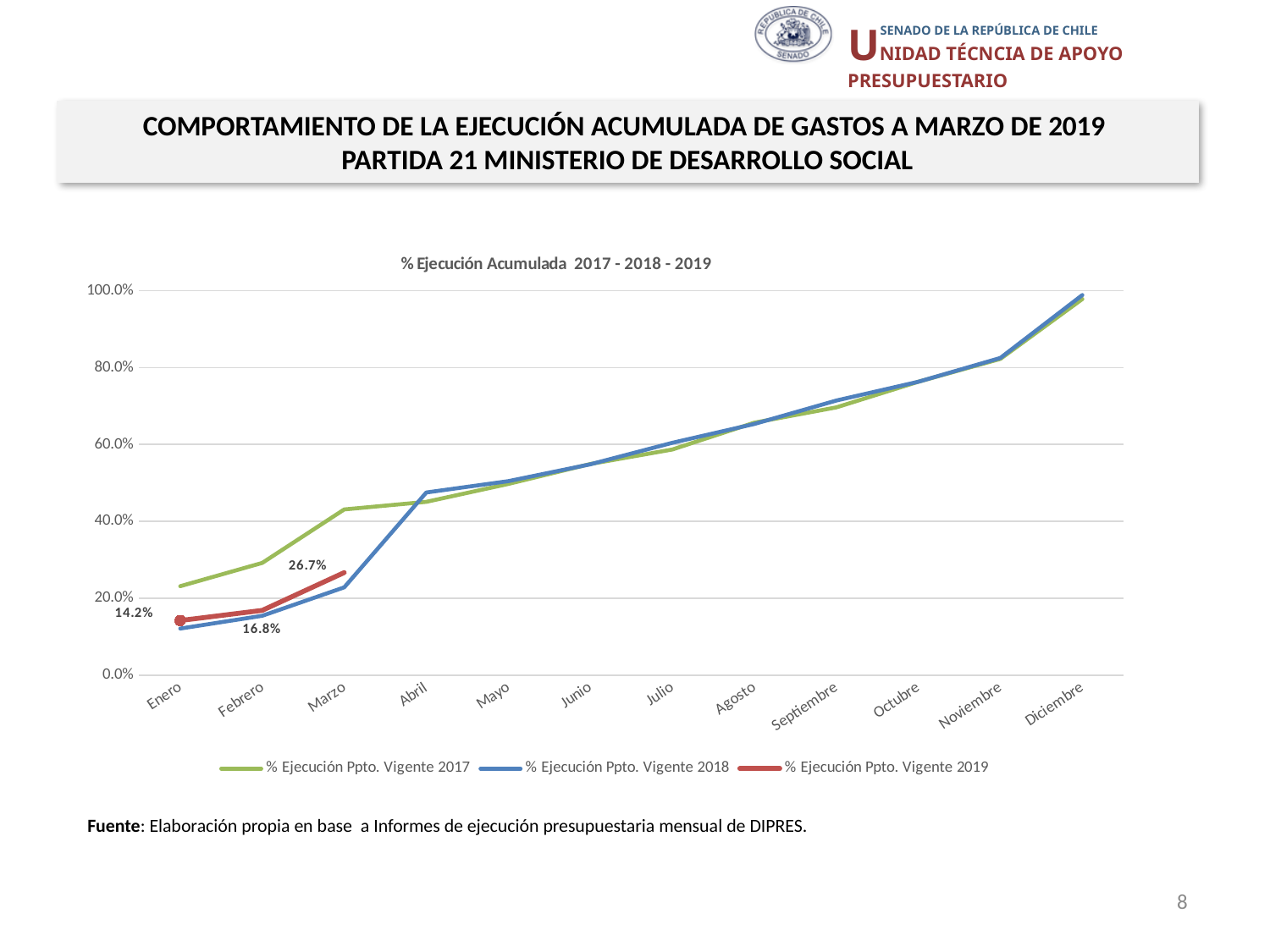
How many series does the legend list? 3 In Marzo, which series has the larger value: % Ejecución Ppto. Vigente 2017 or % Ejecución Ppto. Vigente 2018? % Ejecución Ppto. Vigente 2017 What is the difference between the Marzo and Enero values of the % Ejecución Ppto. Vigente 2019 series? 12.5% What is the value for Marzo in the % Ejecución Ppto. Vigente 2019 series? 26.7% What is the difference between the Marzo and Febrero values of the % Ejecución Ppto. Vigente 2019 series? 9.9% How many months are shown on the x axis of the chart? 12 What is the title of the chart? % Ejecución Acumulada 2017 - 2018 - 2019 What kind of chart is shown on the slide? Line chart What is the value for Enero in the % Ejecución Ppto. Vigente 2019 series? 14.2% Do the values of the % Ejecución Ppto. Vigente 2019 series rise or fall from Enero to Marzo? Rise What is the value for Febrero in the % Ejecución Ppto. Vigente 2019 series? 16.8% Is the value for Marzo in the % Ejecución Ppto. Vigente 2017 series greater or less than 40%? greater